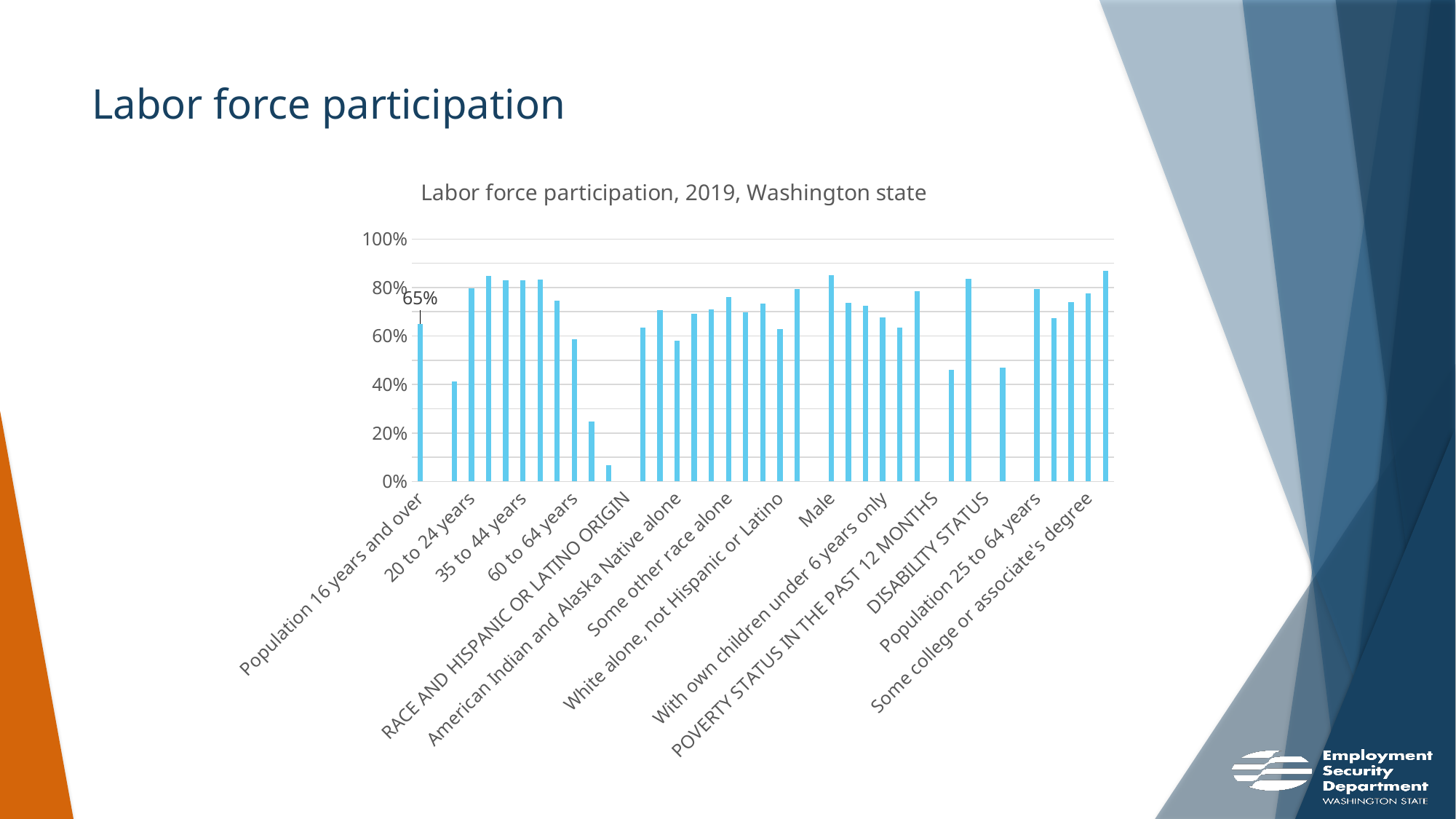
What is the title of the chart? Labor force participation, 2019, Washington state What type of chart is shown on the slide? bar chart Is the value for Population 16 years and over greater or less than 80%? less Is the value for Population 16 years and over greater or less than 60%? greater Which year does the chart's data refer to? 2019 What is the labor force participation value shown for Population 16 years and over? 65% What is the highest value shown on the chart's vertical axis? 100%